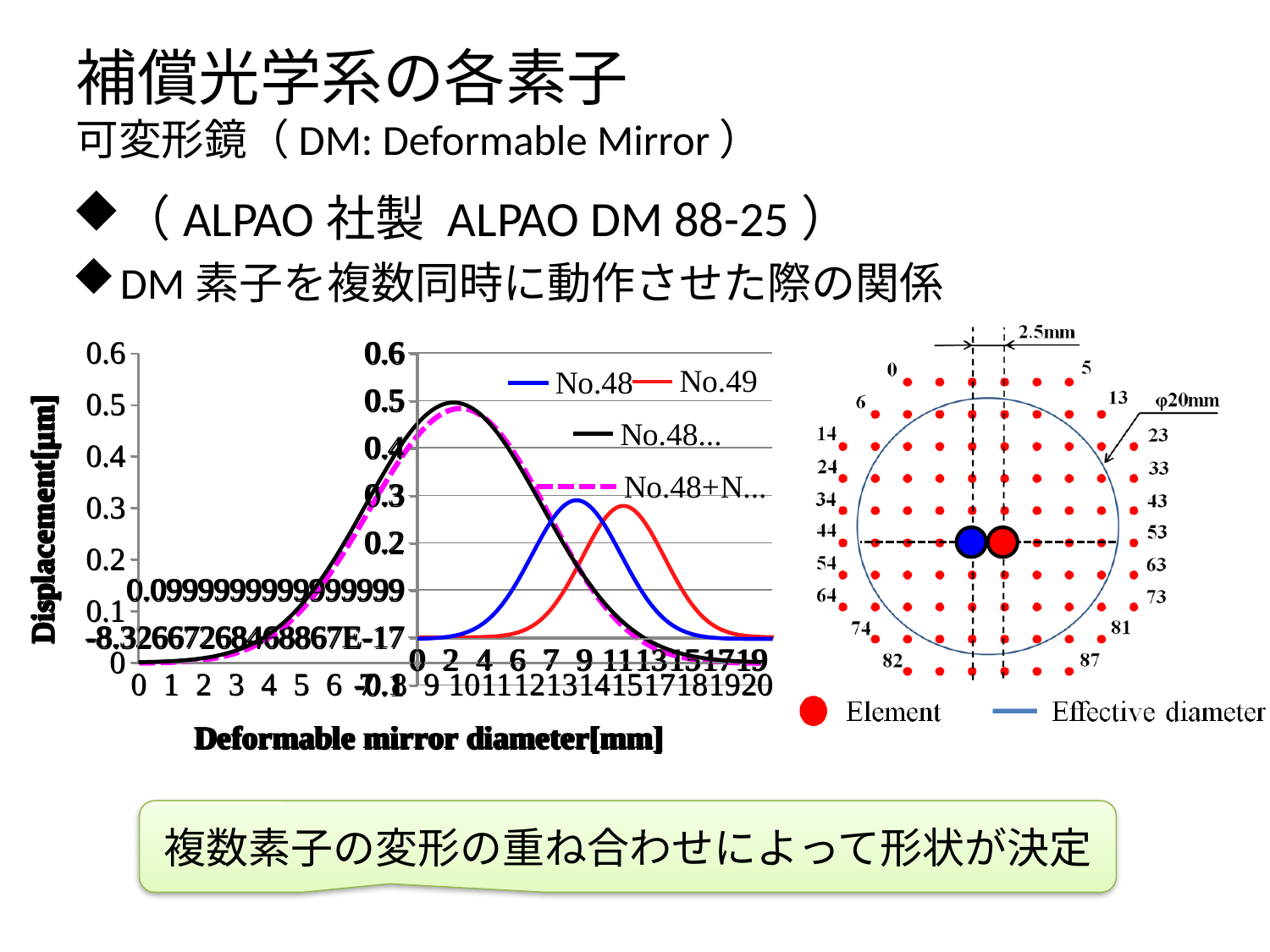
What is the x-axis title of the line chart? Deformable mirror diameter[mm] What is the y-axis title of the line chart? Displacement[μm] What kind of chart is shown on the left of the slide? line chart In the line chart, is the peak value of the No.48 (blue) line greater or less than 0.2? greater In the line chart, is the peak value of the No.49 (red) line greater or less than 0.4? less How many series does the legend of the line chart list? 4 In the line chart, which reaches a higher peak: the black No.48... line or the blue No.48 line? the black No.48... line In the line chart, which reaches a higher peak: the magenta dashed No.48+N... line or the red No.49 line? the magenta dashed No.48+N... line In the line chart, is the peak value of the black No.48... line greater or less than 0.4? greater